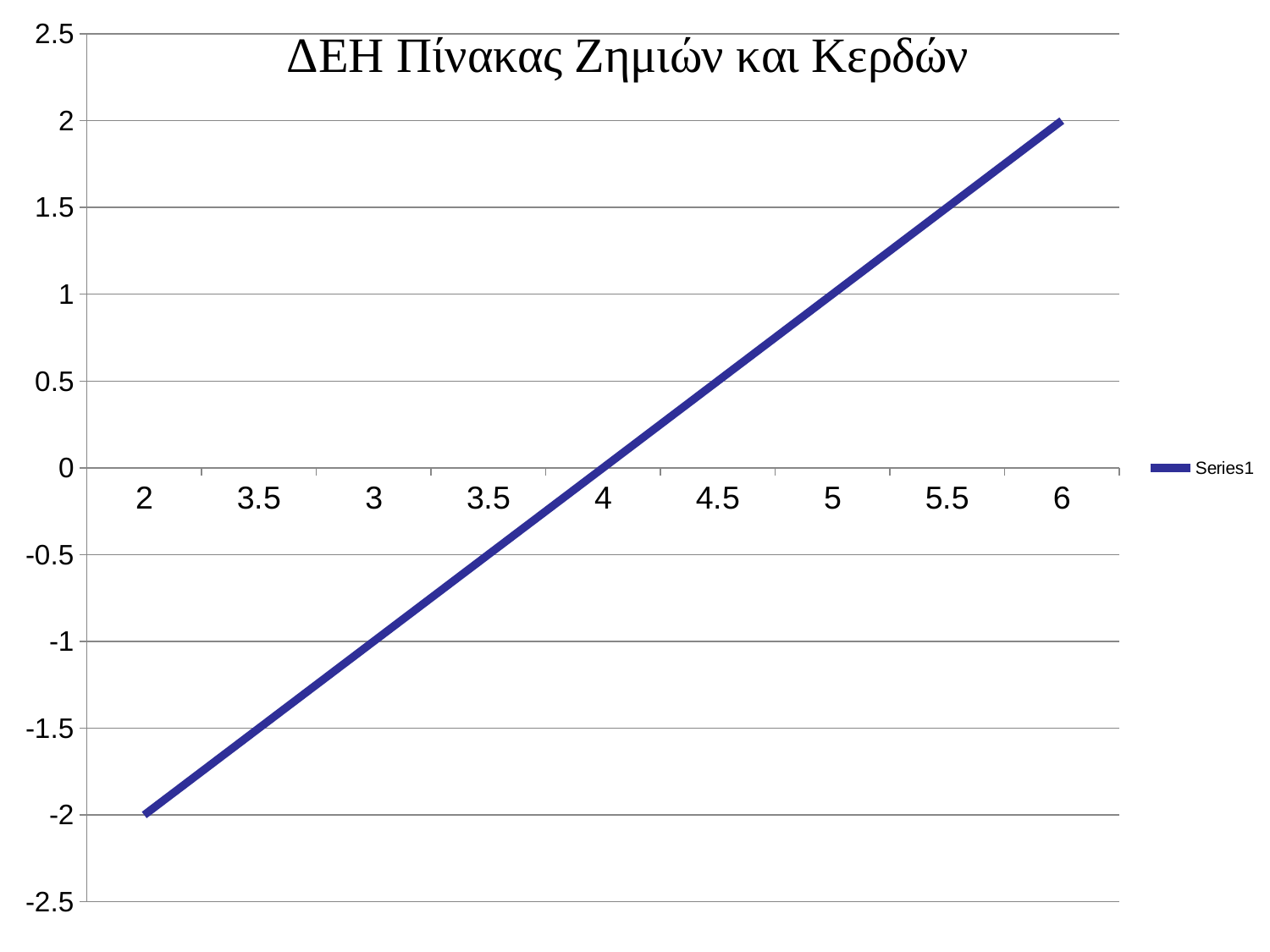
What kind of chart is shown on the slide? line chart Which has the larger value, x = 5 or x = 3? 5 At which x-axis category is the value lowest? 2 Do the values rise or fall as you move from left to right along the x axis? rise What is the value of Series1 at x = 4? 0 Is the value at x = 5.5 greater or less than 1? greater What is the value of Series1 at x = 2? -2 What is the value of Series1 at x = 6? 2 What is the title of the chart? ΔΕΗ Πίνακας Ζημιών και Κερδών At which x-axis category is the value highest? 6 How many series does the legend list? 1 How many categories are shown along the x axis? 9